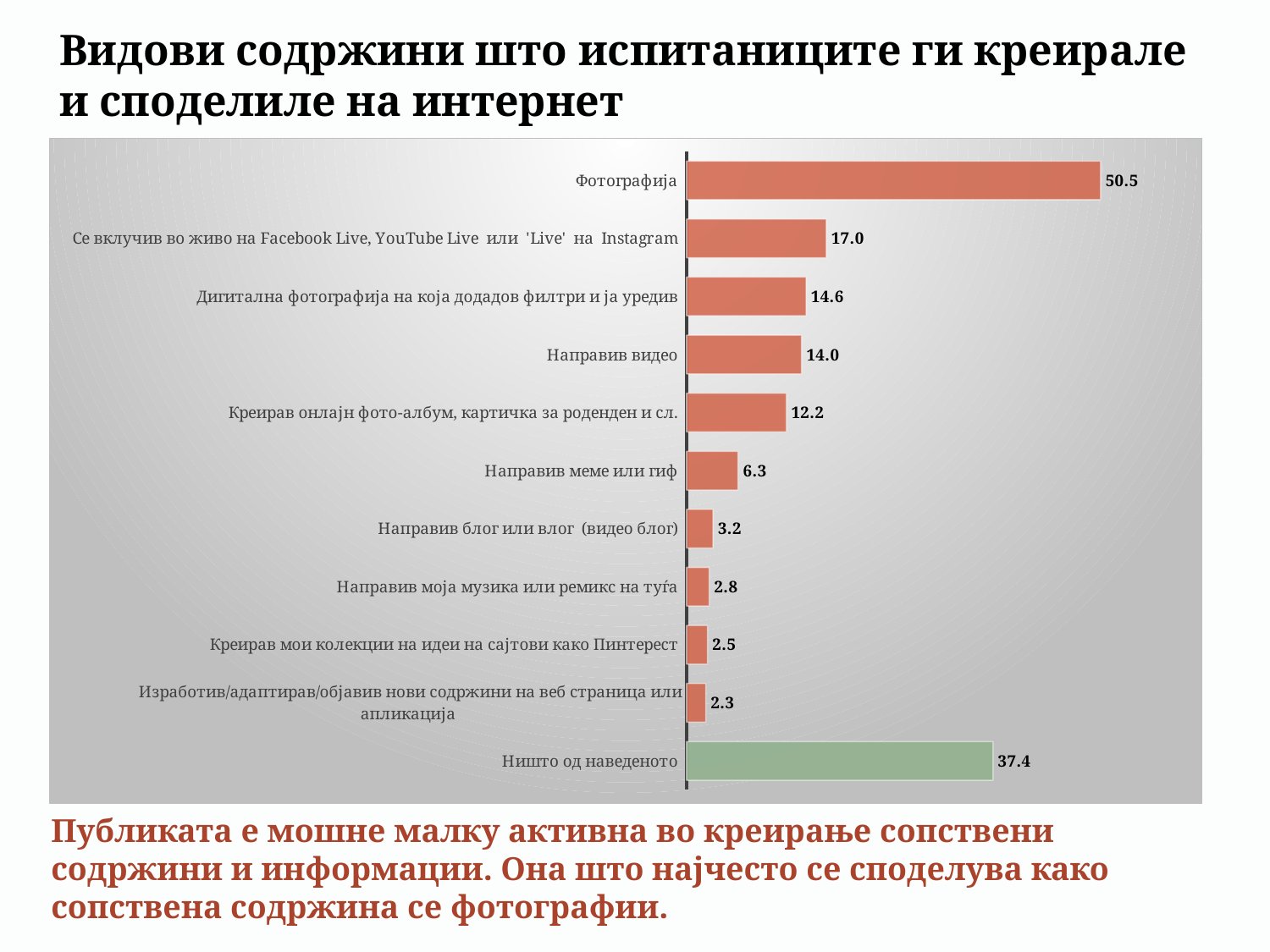
Which category has the lowest value? Изработив/адаптирав/објавив нови содржини на веб страница или апликација What kind of chart is shown on the slide? bar chart What is the value for Направив видео? 14.0 What is the difference between the values for Фотографија and Ништо од наведеното? 13.1 What is the difference between the values for Се вклучив во живо на Facebook Live, YouTube Live или 'Live' на Instagram and Дигитална фотографија на која додадов филтри и ја уредив? 2.4 Which is larger: the value for Направив видео or the value for Креирав онлајн фото-албум, картичка за роденден и сл.? Направив видео What is the value for Фотографија? 50.5 What is the value for Ништо од наведеното? 37.4 Which bar is shown in a different colour (green) from the others? Ништо од наведеното What is the value for Направив меме или гиф? 6.3 How many categories are shown in the chart? 11 Which category has the highest value? Фотографија